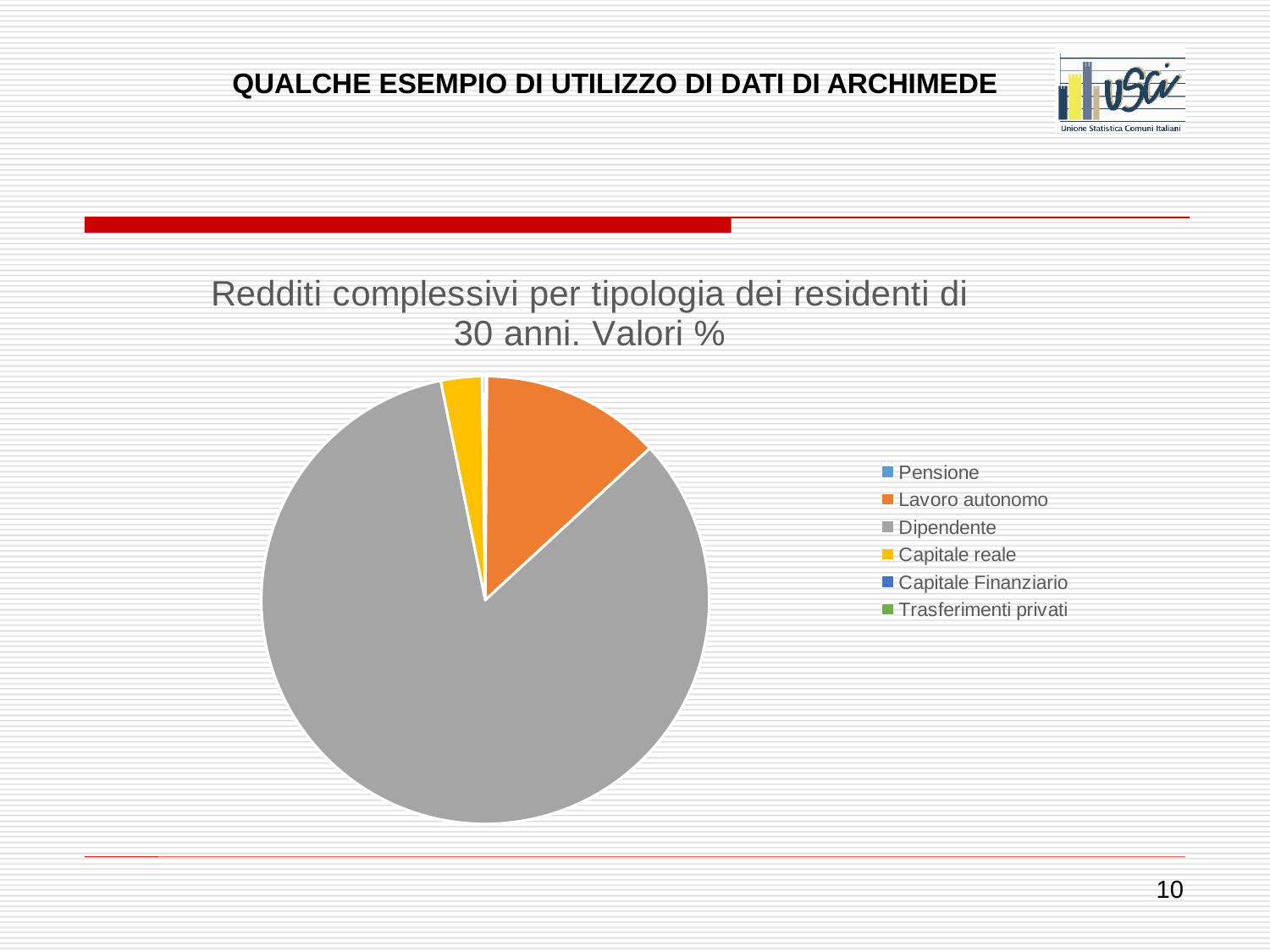
How many categories does the legend of the pie chart list? 6 Which category has the second-largest slice of the pie? Lavoro autonomo Which slice is larger, Lavoro autonomo or Capitale reale? Lavoro autonomo Does the Dipendente slice take up more or less than half of the pie? more Which slice is larger, Dipendente or Lavoro autonomo? Dipendente Which category has the largest slice of the pie? Dipendente What kind of chart is shown on the slide? Pie chart What is the title of the chart? Redditi complessivi per tipologia dei residenti di 30 anni. Valori % Which category is shown in grey in the pie chart? Dipendente